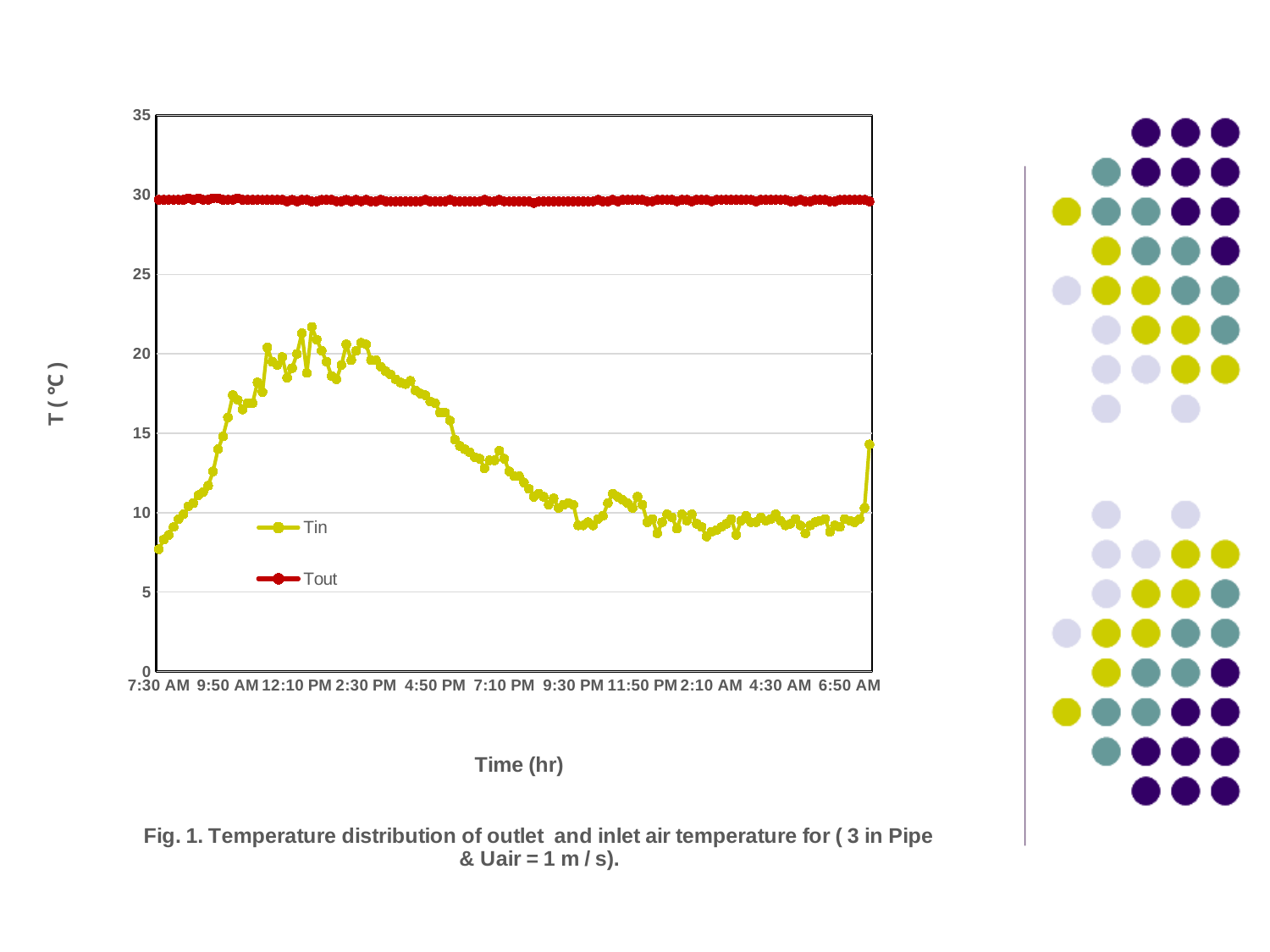
Which series has the higher value at 4:50 PM, Tin or Tout? Tout Is the value of Tin at 12:10 PM greater or less than 15? greater Is the value of Tin at 2:10 AM greater or less than 15? less Does Tin rise or fall between 7:30 AM and 12:10 PM? rise Does Tin rise or fall between 2:30 PM and 9:30 PM? fall What is the title of the x axis? Time (hr) What kind of chart is shown on the slide? line chart Is the highest value reached by Tin greater or less than 25? less What are the two series named in the legend? Tin and Tout How many series does the legend list? 2